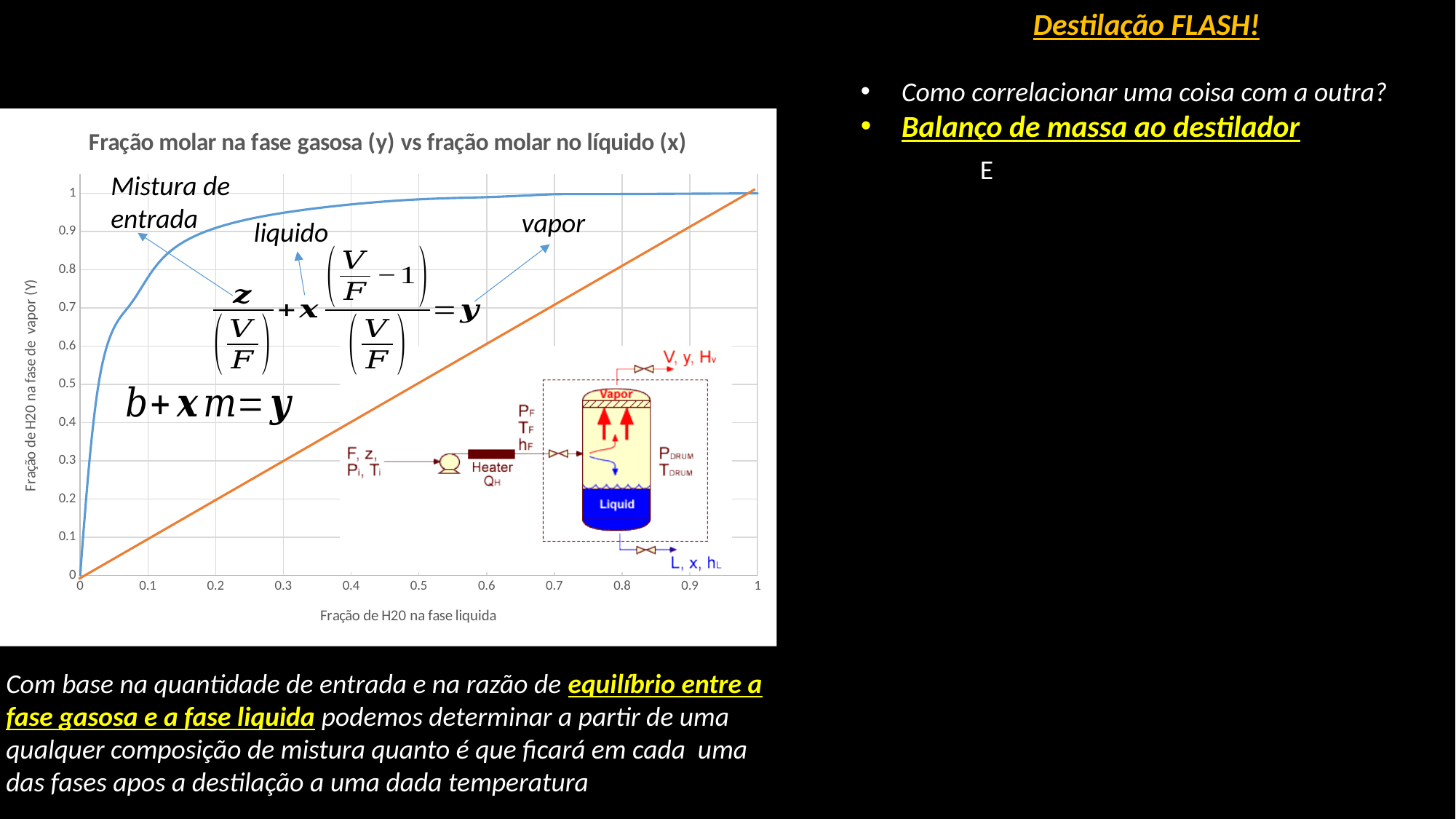
Is the value of the blue curve at x = 0.1 greater or less than 0.7? greater What is the label of the horizontal axis of the chart? Fração de H20 na fase liquida Is the value of the blue curve at x = 0.5 greater or less than 0.9? greater Does the orange line rise or fall as the x value increases from 0 to 1? rise Is the value of the orange line at x = 0.5 greater or less than 0.8? less What is the highest value shown on the x axis of the chart? 1 What kind of chart is shown on the slide? line chart Does the blue curve rise or fall as the x value increases from 0 to 1? rise How many lines are plotted on the chart? 2 What is the title of the chart? Fração molar na fase gasosa (y) vs fração molar no líquido (x) At x = 0.3, which line has the higher y value, the blue curve or the orange line? the blue curve